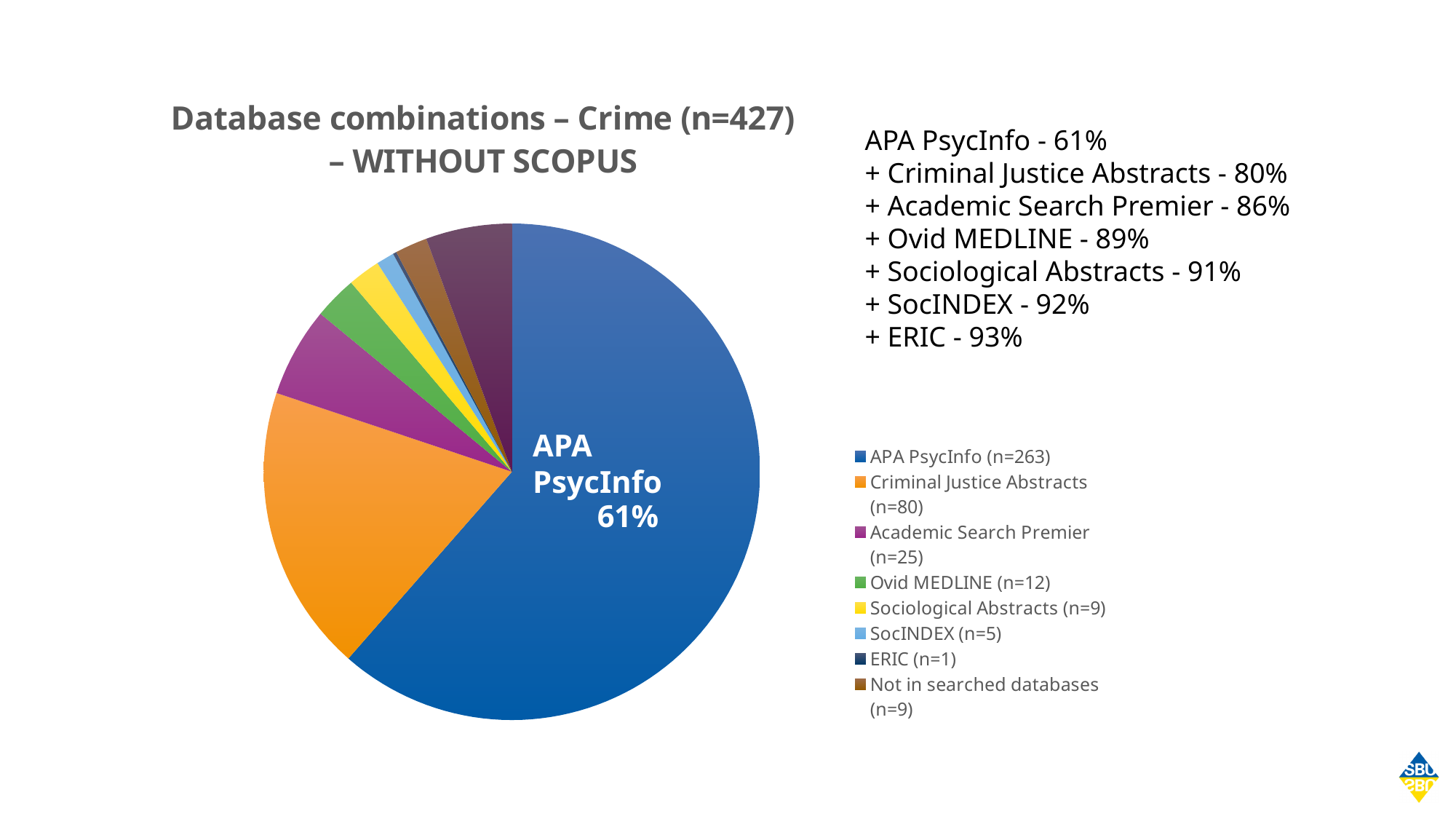
Which legend category has the smallest slice of the pie chart? ERIC What kind of chart is shown on the slide? pie chart What is the n value shown in the legend for Academic Search Premier? 25 What is the n value shown in the legend for Criminal Justice Abstracts? 80 What is the difference between the n values for APA PsycInfo and Criminal Justice Abstracts? 183 How many slices does the pie chart have? 9 What share of the pie does APA PsycInfo account for? 61% Which has a larger n value, Sociological Abstracts or SocINDEX? Sociological Abstracts What is the n value shown in the legend for Ovid MEDLINE? 12 What is the title of the pie chart? Database combinations – Crime (n=427) – WITHOUT SCOPUS What colour is the slice for Criminal Justice Abstracts? orange Which database has the largest slice of the pie chart? APA PsycInfo